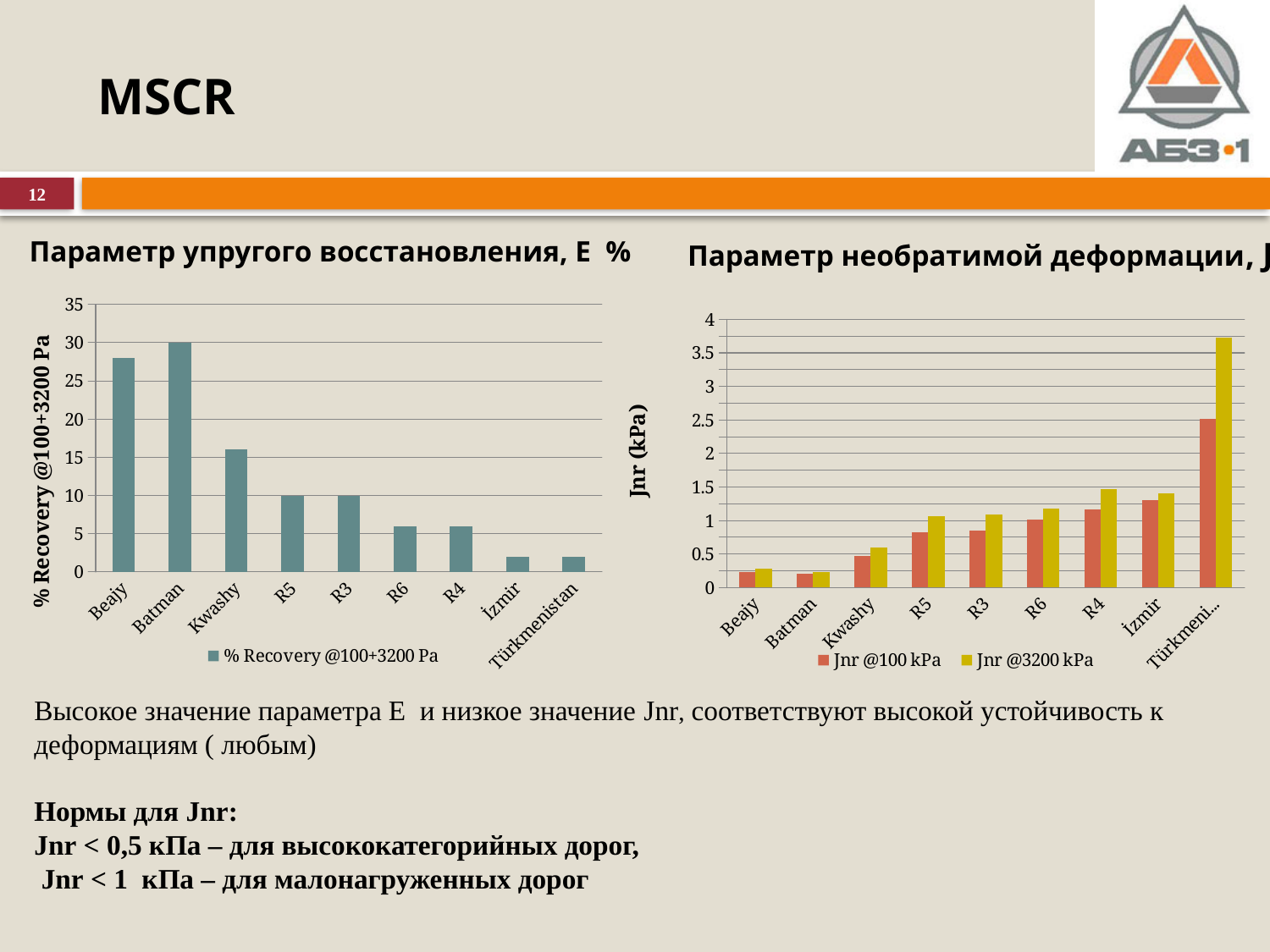
In the right chart (Jnr), is the Jnr @3200 kPa value for Türkmenistan greater or less than 3.5? greater In the right chart (Jnr), which has the larger Jnr @100 kPa value, Beajy or R4? R4 In the left chart (% Recovery @100+3200 Pa), which category has the highest value? Batman In the right chart (Jnr), which category has the highest Jnr @3200 kPa value? Türkmenistan In the left chart (% Recovery @100+3200 Pa), what is the value for Batman? 30 What is the y-axis title of the right chart? Jnr (kPa) What kind of chart is the left chart, '% Recovery @100+3200 Pa'? bar chart How many series does the legend of the right chart (Jnr) list? 2 In the left chart (% Recovery @100+3200 Pa), do the values generally rise or fall from left to right along the x axis? fall In the left chart (% Recovery @100+3200 Pa), is the value for Beajy greater or less than 25? greater In the left chart (% Recovery @100+3200 Pa), what is the value for R5? 10 How many categories are shown on the x axis of the left chart (% Recovery @100+3200 Pa)? 9